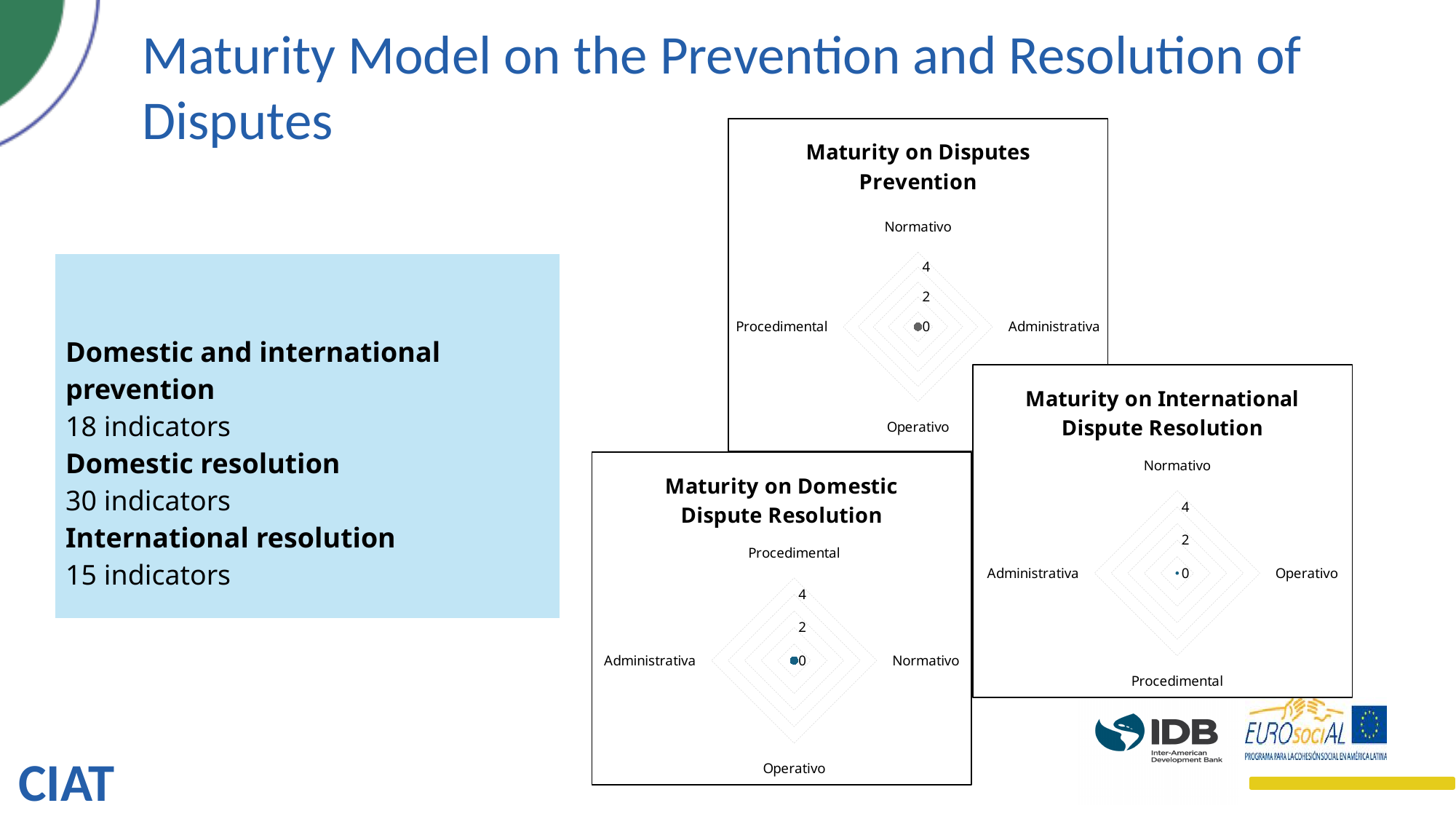
In the "Maturity on Disputes Prevention" chart, is the value for Normativo greater or less than 2? less What is the highest tick value shown on the axis of the "Maturity on Domestic Dispute Resolution" chart? 4 What kind of chart is the "Maturity on Domestic Dispute Resolution" chart? radar chart What kind of chart is the "Maturity on Disputes Prevention" chart? radar chart How many axes (categories) does the "Maturity on Disputes Prevention" radar chart have? 4 In the "Maturity on International Dispute Resolution" chart, is the value for Operativo greater or less than 2? less How many radar charts are shown on the slide? 3 How many categories are plotted on the "Maturity on International Dispute Resolution" radar chart? 4 Which category label appears at the top of the "Maturity on International Dispute Resolution" chart? Normativo In the "Maturity on Domestic Dispute Resolution" chart, is the value for Administrativa greater or less than 2? less